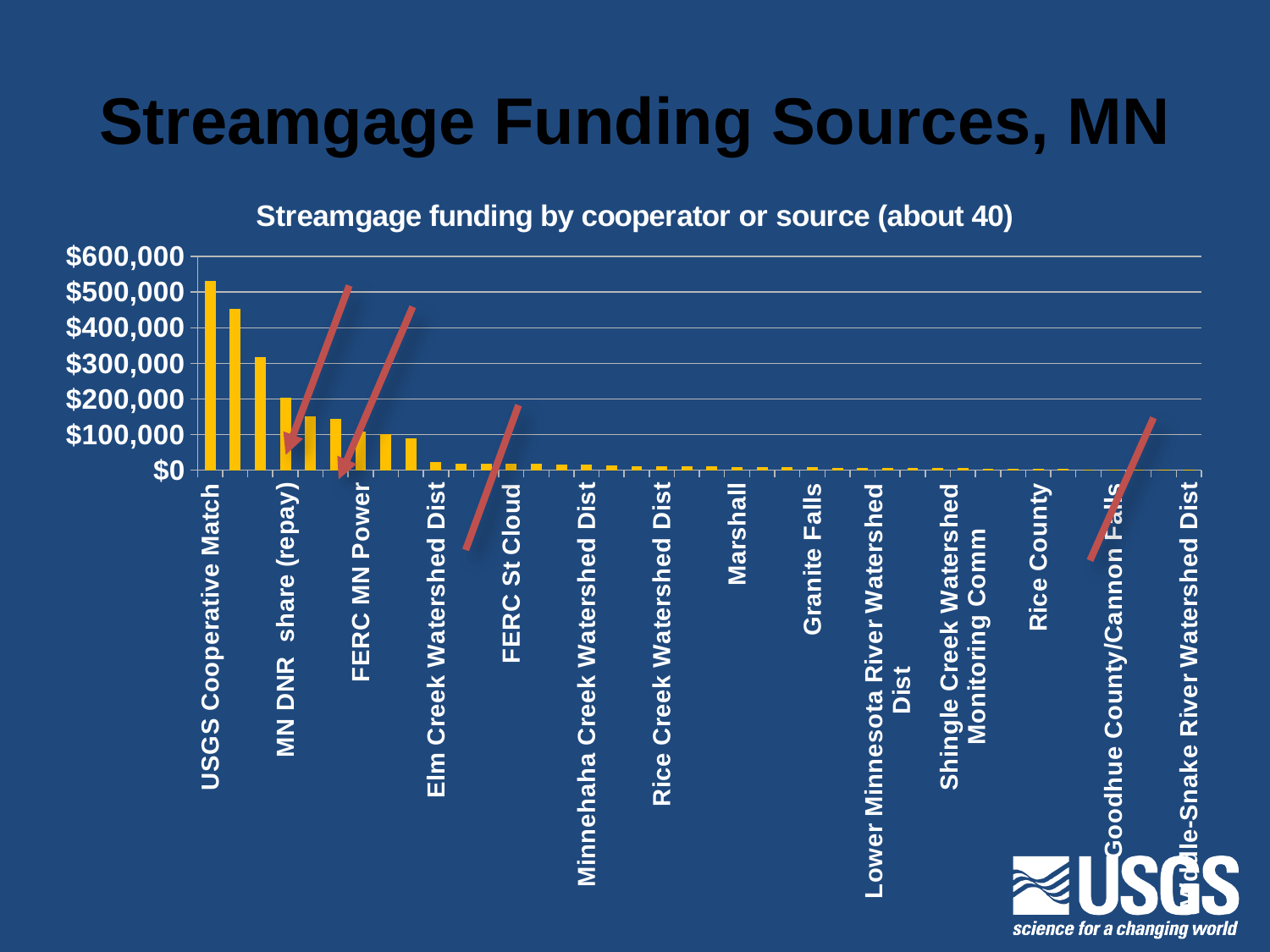
What type of chart is shown on the slide? bar chart Is the value for Marshall greater or less than $100,000? less Do the funding values generally rise or fall from left to right along the x axis? fall What is the highest value shown on the y axis? $600,000 Which is larger, the value for FERC MN Power or the value for Elm Creek Watershed Dist? FERC MN Power Is the value for MN DNR share (repay) greater or less than $300,000? less Is the value for Elm Creek Watershed Dist greater or less than $100,000? less Which cooperator or source has the highest funding value? USGS Cooperative Match Which is larger, the value for USGS Cooperative Match or the value for MN DNR share (repay)? USGS Cooperative Match What is the title of the chart? Streamgage funding by cooperator or source (about 40)